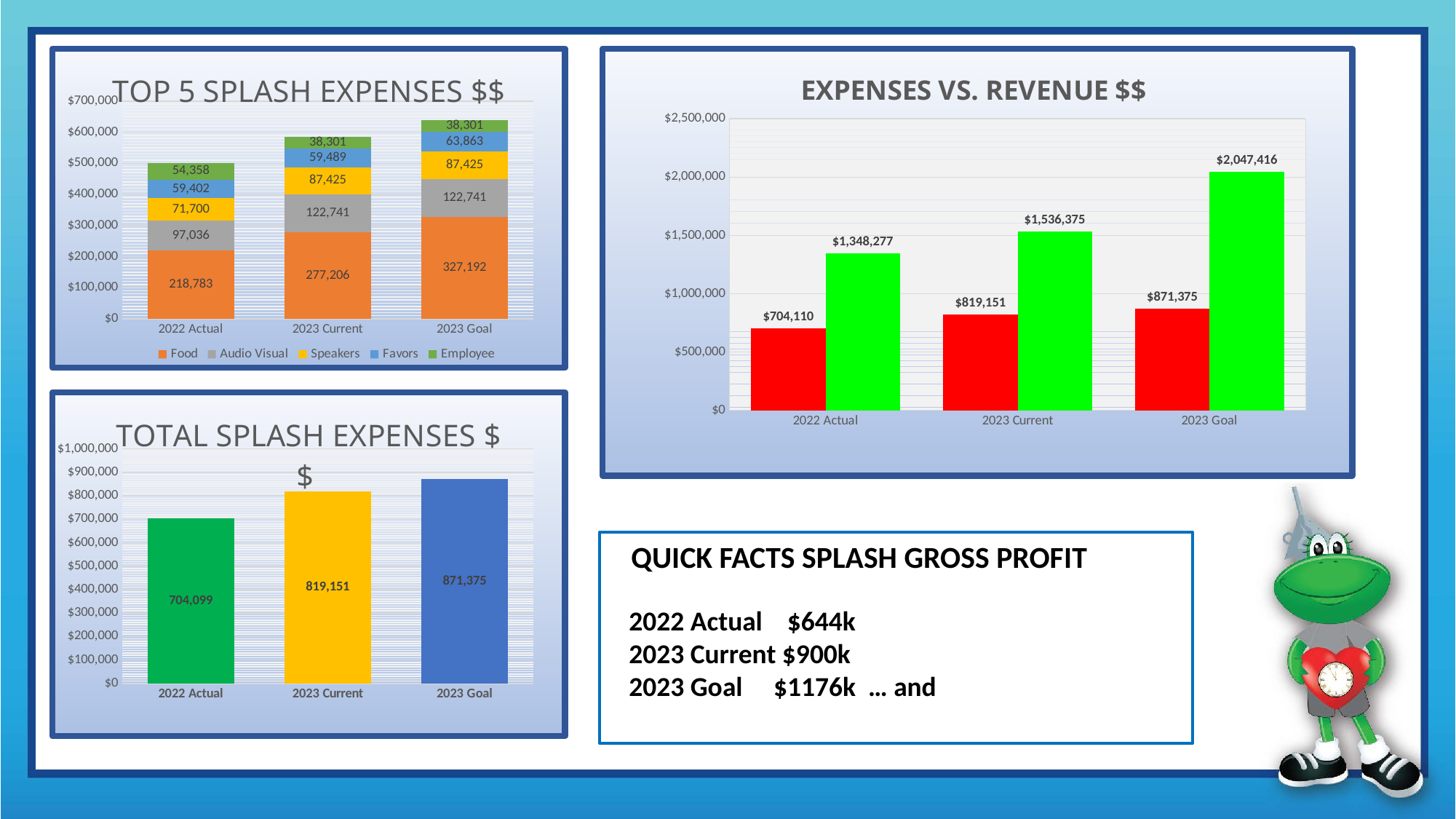
In the TOTAL SPLASH EXPENSES $ chart, what is the value for 2023 Current? 819,151 In the TOP 5 SPLASH EXPENSES $$ chart, how many series does the legend list? 5 In the EXPENSES VS. REVENUE $$ chart, what is the difference between the green and red bars for 2023 Goal? $1,176,041 In the TOP 5 SPLASH EXPENSES $$ chart, what is the total of the 2022 Actual stacked bar? 501,279 In the TOTAL SPLASH EXPENSES $ chart, what is the difference between 2023 Goal and 2022 Actual? 167,276 What kind of chart is the TOTAL SPLASH EXPENSES $ chart? bar chart In the TOP 5 SPLASH EXPENSES $$ chart, which category has the largest Employee value? 2022 Actual In the TOTAL SPLASH EXPENSES $ chart, do the values rise or fall from left to right? rise In the EXPENSES VS. REVENUE $$ chart, what is the value of the green bar for 2023 Goal? $2,047,416 In the EXPENSES VS. REVENUE $$ chart, how many categories are shown on the x axis? 3 In the TOP 5 SPLASH EXPENSES $$ chart, what is the Food value for 2023 Goal? 327,192 In the TOP 5 SPLASH EXPENSES $$ chart, what is the Audio Visual value for 2022 Actual? 97,036